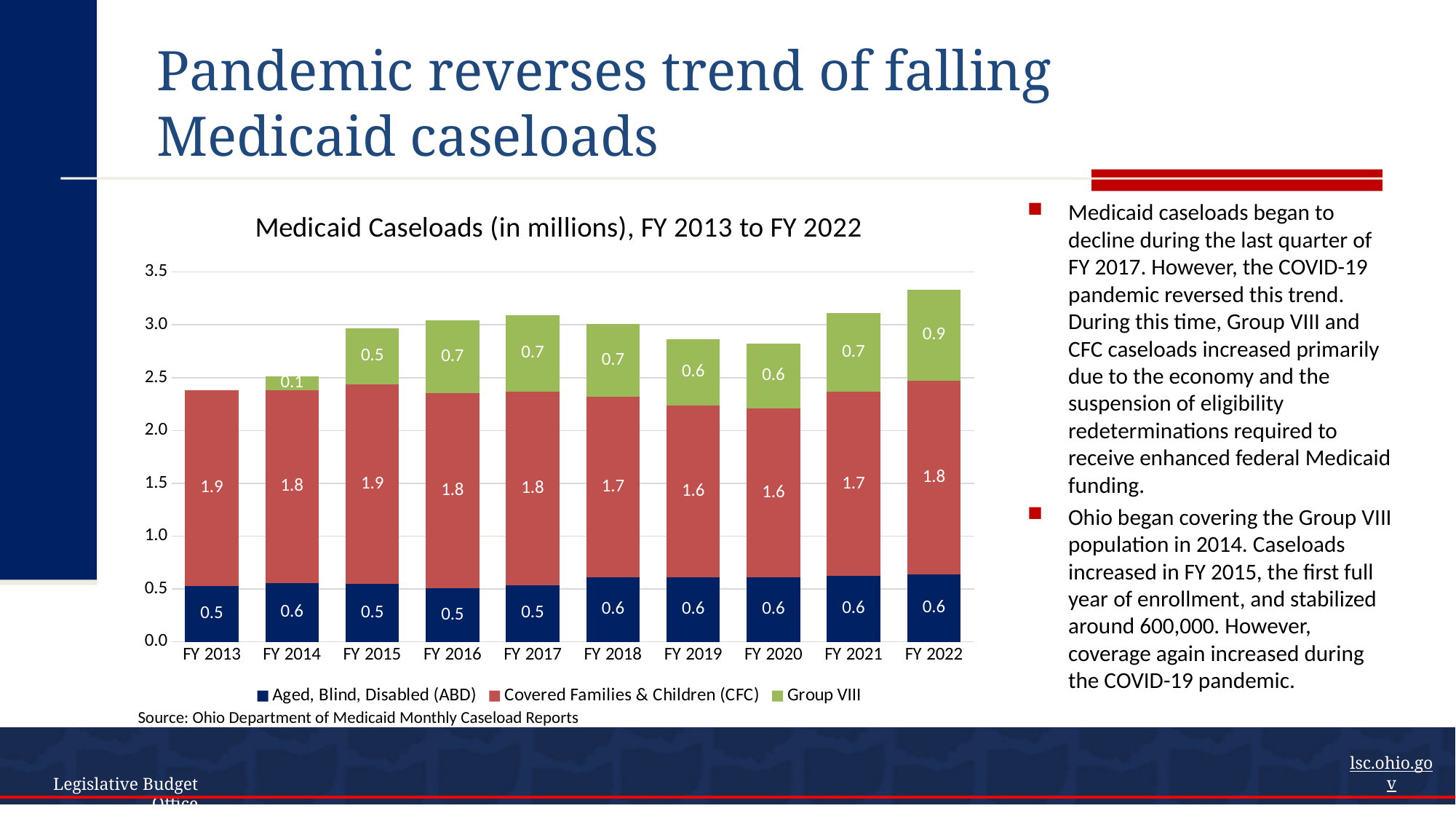
What is the Aged, Blind, Disabled (ABD) value for FY 2016? 0.5 How many series does the legend list? 3 Which is larger, the Group VIII value for FY 2015 or for FY 2016? FY 2016 Is the total stacked bar for FY 2022 greater or less than 3.0? greater What is the Covered Families & Children (CFC) value for FY 2013? 1.9 How many fiscal years are shown on the x axis? 10 Is the total stacked bar for FY 2013 greater or less than 2.5? less What kind of chart is shown on the slide? Stacked bar chart In which fiscal year is the Group VIII value highest? FY 2022 What is the difference between the Group VIII value in FY 2022 and in FY 2014? 0.8 What is the Group VIII value for FY 2022? 0.9 Among the years with a Group VIII label, which fiscal year has the lowest Group VIII value? FY 2014